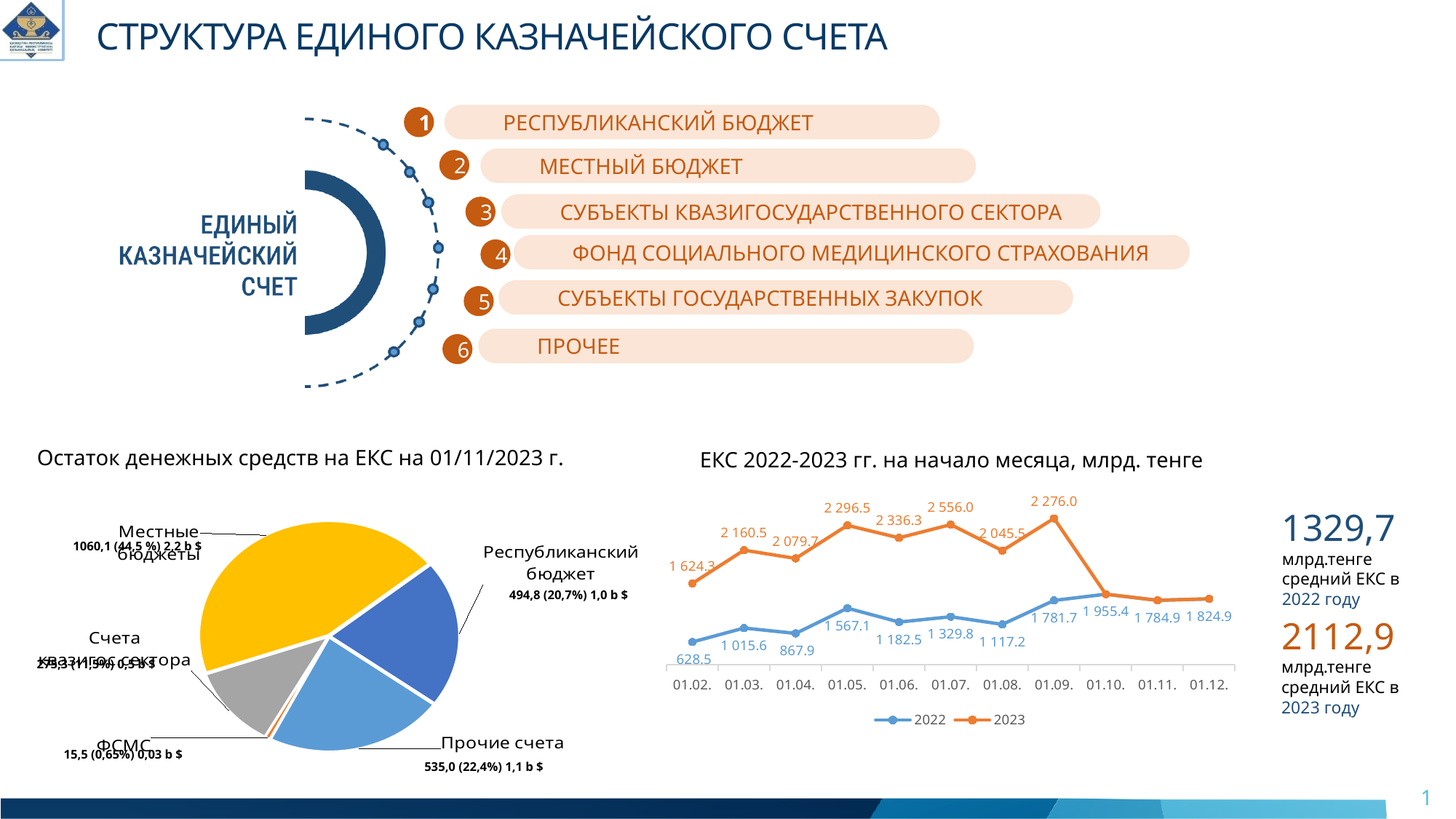
In the pie chart 'Остаток денежных средств на ЕКС на 01/11/2023 г.', what is the value for 'Прочие счета'? 535,0 In the chart 'ЕКС 2022-2023 гг. на начало месяца, млрд. тенге', at which date is the 2022 series lowest? 01.02. In the chart 'ЕКС 2022-2023 гг. на начало месяца, млрд. тенге', how many series does the legend list? 2 What kind of chart is the chart titled 'ЕКС 2022-2023 гг. на начало месяца, млрд. тенге'? line chart In the chart 'ЕКС 2022-2023 гг. на начало месяца, млрд. тенге', at which date is the 2023 series highest? 01.07. In the chart 'ЕКС 2022-2023 гг. на начало месяца, млрд. тенге', what is the difference between the 2022 values at 01.12. and 01.11.? 40.0 In the pie chart 'Остаток денежных средств на ЕКС на 01/11/2023 г.', which slice is the smallest? ФСМС In the chart 'ЕКС 2022-2023 гг. на начало месяца, млрд. тенге', which series has the larger value at 01.03., 2022 or 2023? 2023 In the pie chart 'Остаток денежных средств на ЕКС на 01/11/2023 г.', what share does 'Местные бюджеты' have? 44,5 % In the chart 'ЕКС 2022-2023 гг. на начало месяца, млрд. тенге', what is the 2022 value at 01.09.? 1 781.7 In the chart 'ЕКС 2022-2023 гг. на начало месяца, млрд. тенге', what is the 2023 value at 01.05.? 2 296.5 In the chart 'ЕКС 2022-2023 гг. на начало месяца, млрд. тенге', how many dates are shown on the x axis? 11